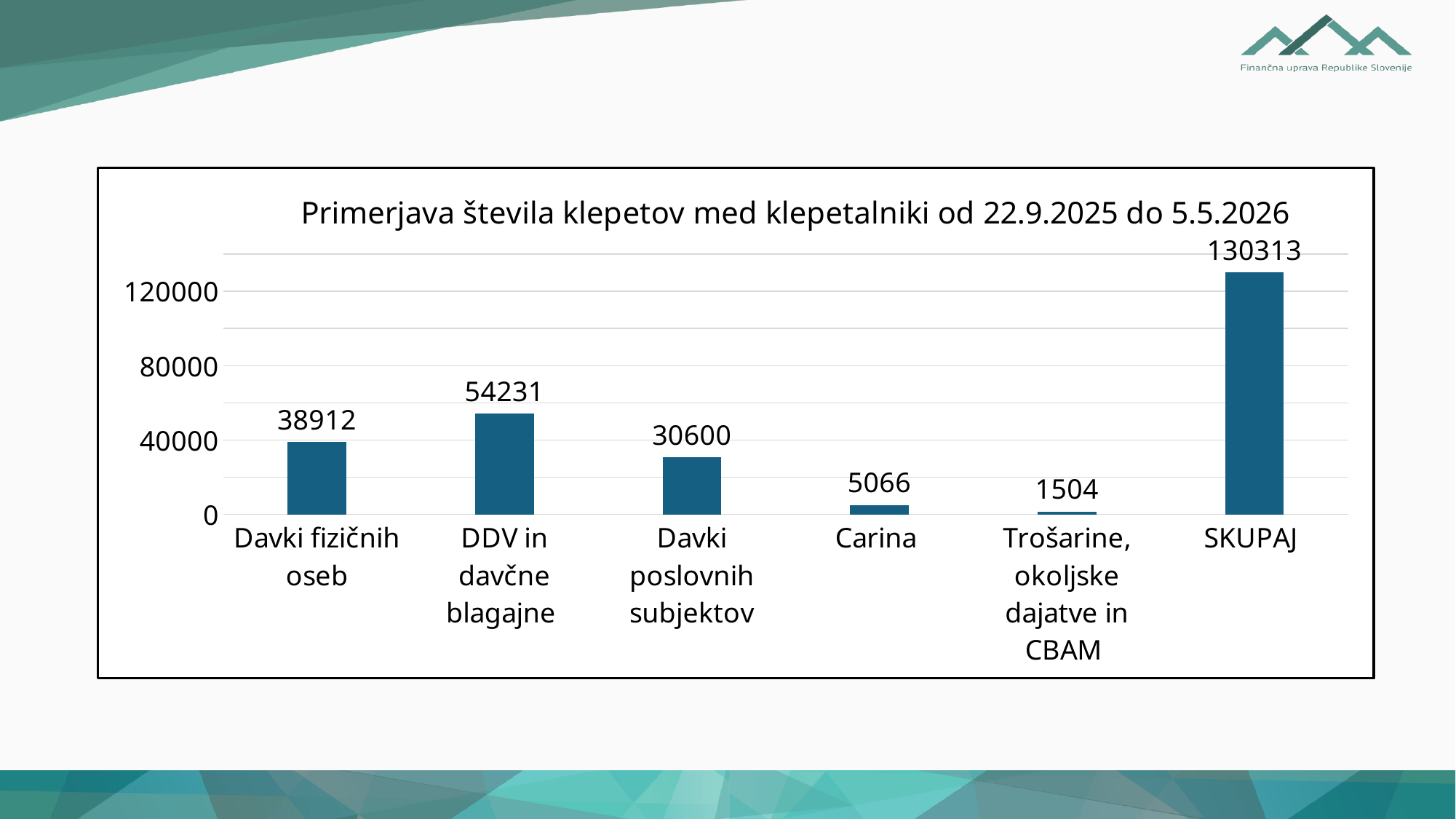
Which is larger, the value for Davki fizičnih oseb or the value for Davki poslovnih subjektov? Davki fizičnih oseb Which category has the lowest value? Trošarine, okoljske dajatve in CBAM Excluding SKUPAJ, which category has the highest value? DDV in davčne blagajne What is the value for DDV in davčne blagajne? 54231 What is the value for Trošarine, okoljske dajatve in CBAM? 1504 What is the value for SKUPAJ? 130313 Is the value for Davki poslovnih subjektov greater or less than 40000? less What is the value for Carina? 5066 What is the title of the chart? Primerjava števila klepetov med klepetalniki od 22.9.2025 do 5.5.2026 What kind of chart is shown on the slide? bar chart What is the difference between the values for DDV in davčne blagajne and Davki fizičnih oseb? 15319 How many categories are shown on the x axis? 6